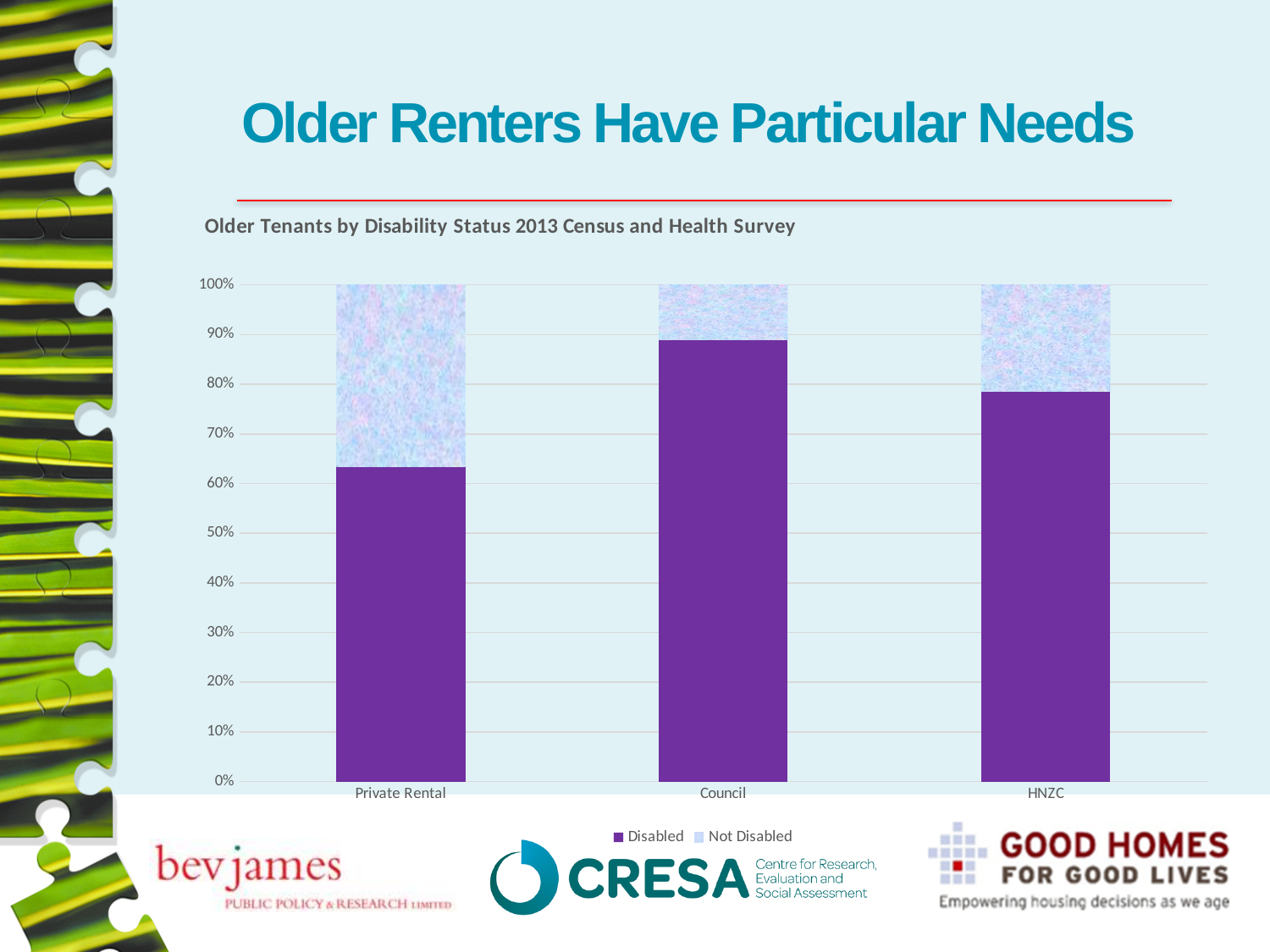
How many series does the chart's legend list? 2 Which is larger, the Disabled share for HNZC or for Private Rental? HNZC Is the Disabled share for HNZC greater or less than 70%? greater Is the Disabled share for Council greater or less than 80%? greater What kind of chart is shown on the slide? Stacked bar chart What is the title of the chart? Older Tenants by Disability Status 2013 Census and Health Survey Is the Disabled share for Private Rental greater or less than 70%? less Which category has the highest Disabled share? Council Which category has the lowest Disabled share? Private Rental Which series are listed in the chart's legend? Disabled, Not Disabled How many categories are shown on the x axis of the chart? 3 Which category has the largest Not Disabled share? Private Rental